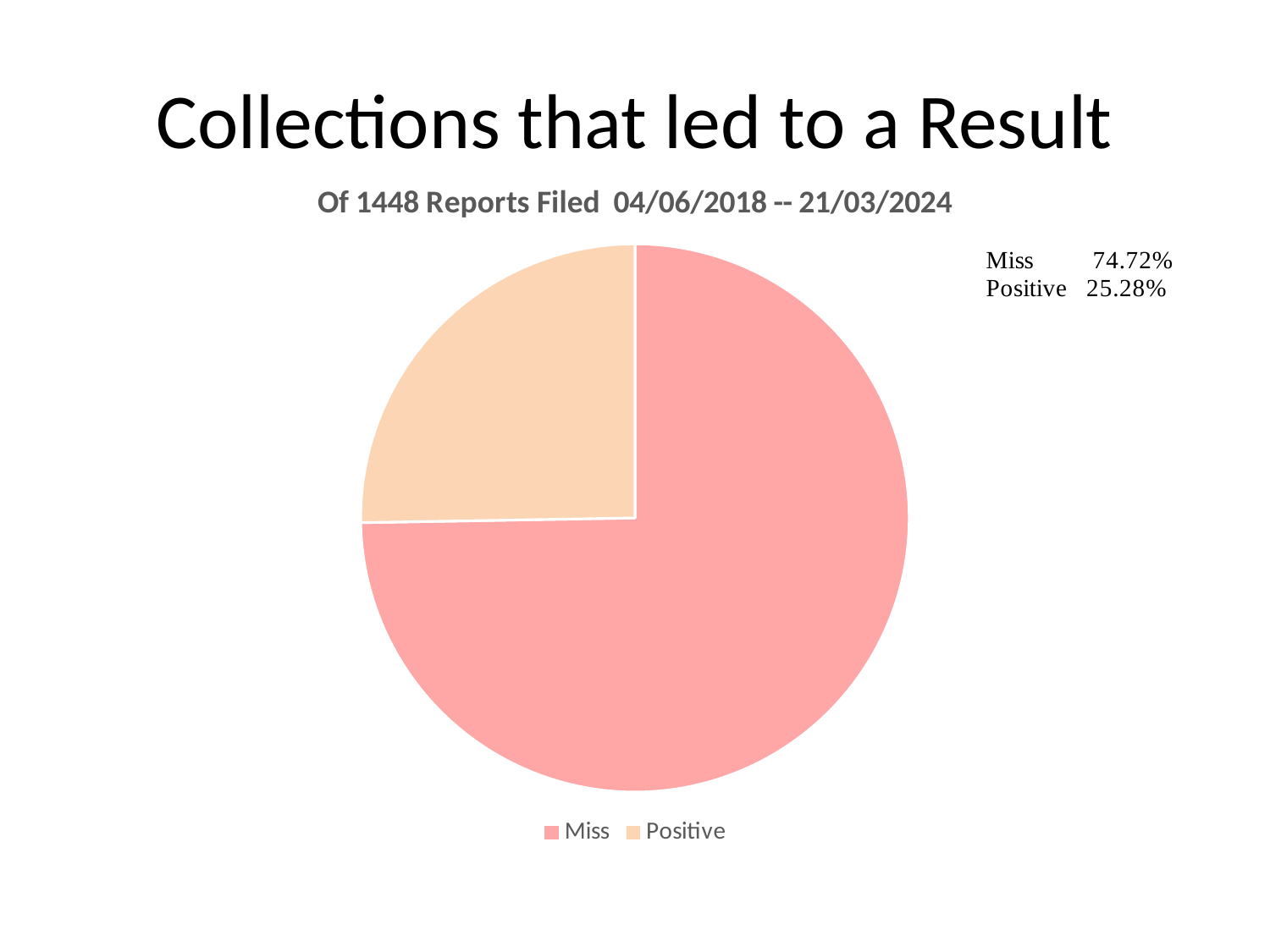
Which colour represents Positive in the pie chart? light orange (peach) What share of the pie does Miss represent? 74.72% Which is larger, the Miss slice or the Positive slice? Miss What share of the pie does Positive represent? 25.28% Which slice of the pie is the largest? Miss What is the difference in percentage points between the Miss share and the Positive share? 49.44 How many entries does the legend list? 2 What is the chart's title? Of 1448 Reports Filed 04/06/2018 -- 21/03/2024 How many slices does the pie chart have? 2 Which slice of the pie is the smallest? Positive How many reports were filed according to the chart title? 1448 What kind of chart is shown on the slide? pie chart